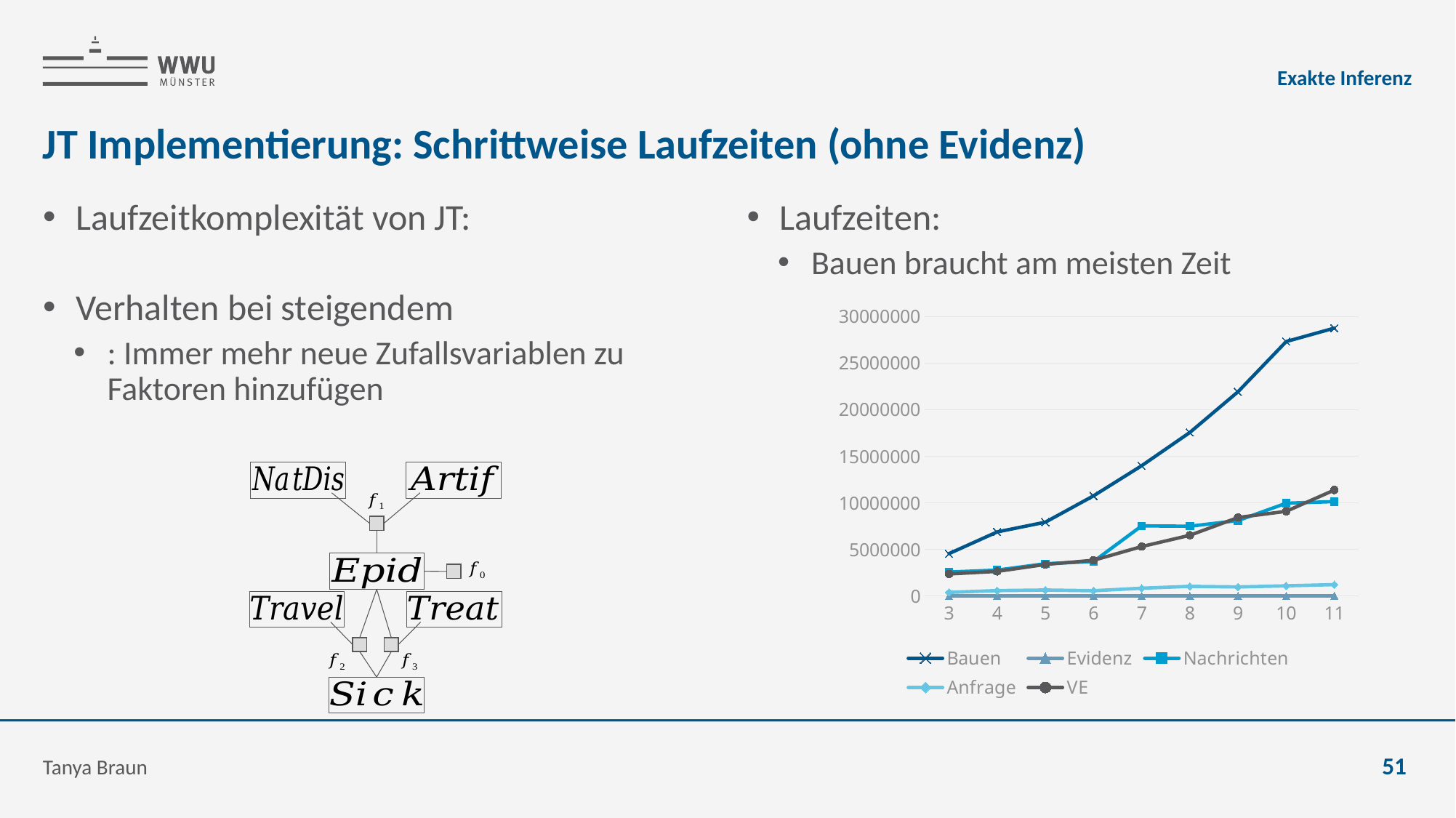
At x = 7, which is larger: Nachrichten or VE? Nachrichten Does the Bauen series rise or fall as x increases from 3 to 11? rises Which legend entry is drawn with x-shaped markers? Bauen How many series does the chart's legend list? 5 Which series has the highest value at x = 11? Bauen Is the value for Bauen at x = 9 greater or less than 20000000? greater Which series has the lowest values across the chart? Evidenz What kind of chart is shown on the slide? line chart Is the value for Nachrichten at x = 7 greater or less than 5000000? greater Is the value for Bauen at x = 11 greater or less than 25000000? greater How many points are on the x axis of the chart? 9